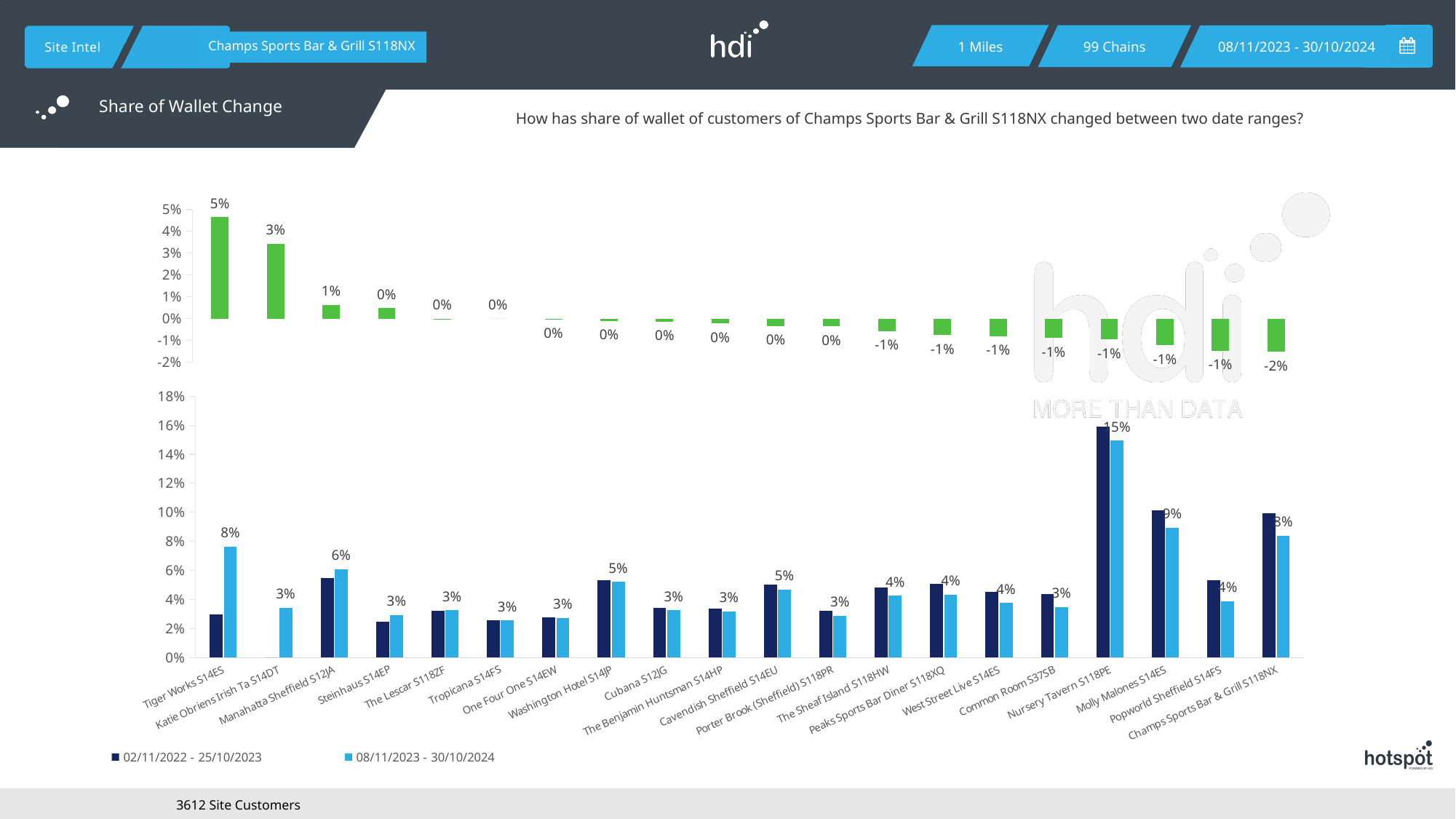
On the top chart (share of wallet change), what is the value for Tiger Works S14ES? 5% On the top chart (share of wallet change), which category has the lowest value? Champs Sports Bar & Grill S118NX On the bottom chart, is the value for Nursery Tavern S118PE in the 02/11/2022 - 25/10/2023 series greater or less than 14%? greater What kind of chart is the bottom chart? Bar chart On the bottom chart, which is larger in the 08/11/2023 - 30/10/2024 series: Tiger Works S14ES or Manahatta Sheffield S12JA? Tiger Works S14ES On the top chart (share of wallet change), which category has the highest value? Tiger Works S14ES On the top chart (share of wallet change), what is the difference between the values for Tiger Works S14ES and Katie Obriens Irish Ta S14DT? 2% On the bottom chart, how many series does the legend list? 2 On the top chart (share of wallet change), what is the value for Champs Sports Bar & Grill S118NX? -2% On the bottom chart, which category has the highest value in the 08/11/2023 - 30/10/2024 series? Nursery Tavern S118PE On the bottom chart, what is the value for Nursery Tavern S118PE in the 08/11/2023 - 30/10/2024 series? 15% On the bottom chart, how many categories are shown on the x axis? 20